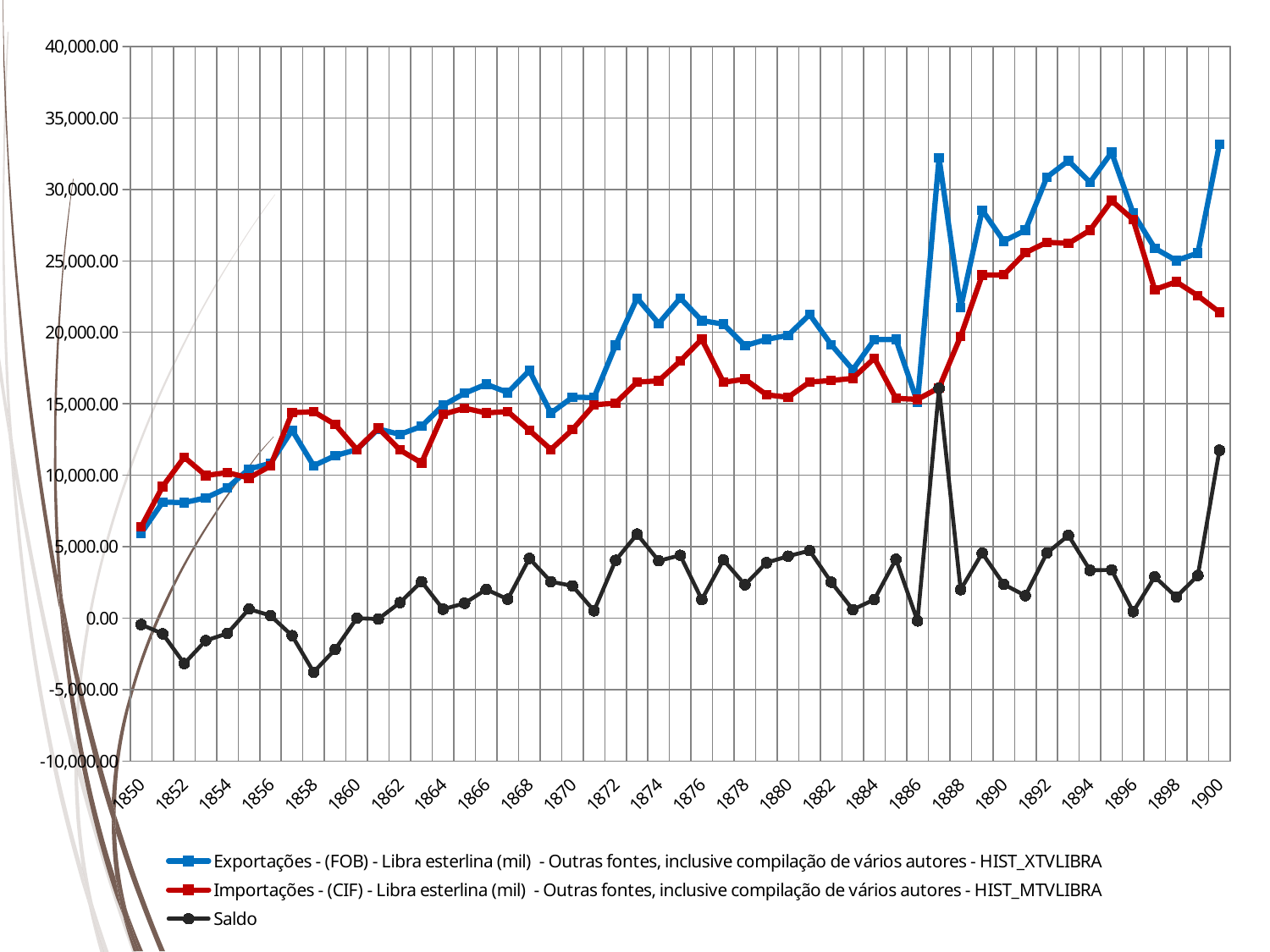
Which series has the lowest value on the chart? Saldo Is the value of Exportações in 1900 greater or less than 30,000.00? greater How many series does the legend list? 3 Do the values of Importações rise or fall from 1896 to 1900? fall In 1852, which is larger: Exportações or Importações? Importações Is the value of Saldo in 1858 greater or less than 0.00? less Which series reaches the highest value on the chart? Exportações Is the value of Importações in 1850 greater or less than 10,000.00? less In 1900, which is larger: Exportações or Importações? Exportações What colour is the Exportações line? blue What kind of chart is shown on the slide? line chart